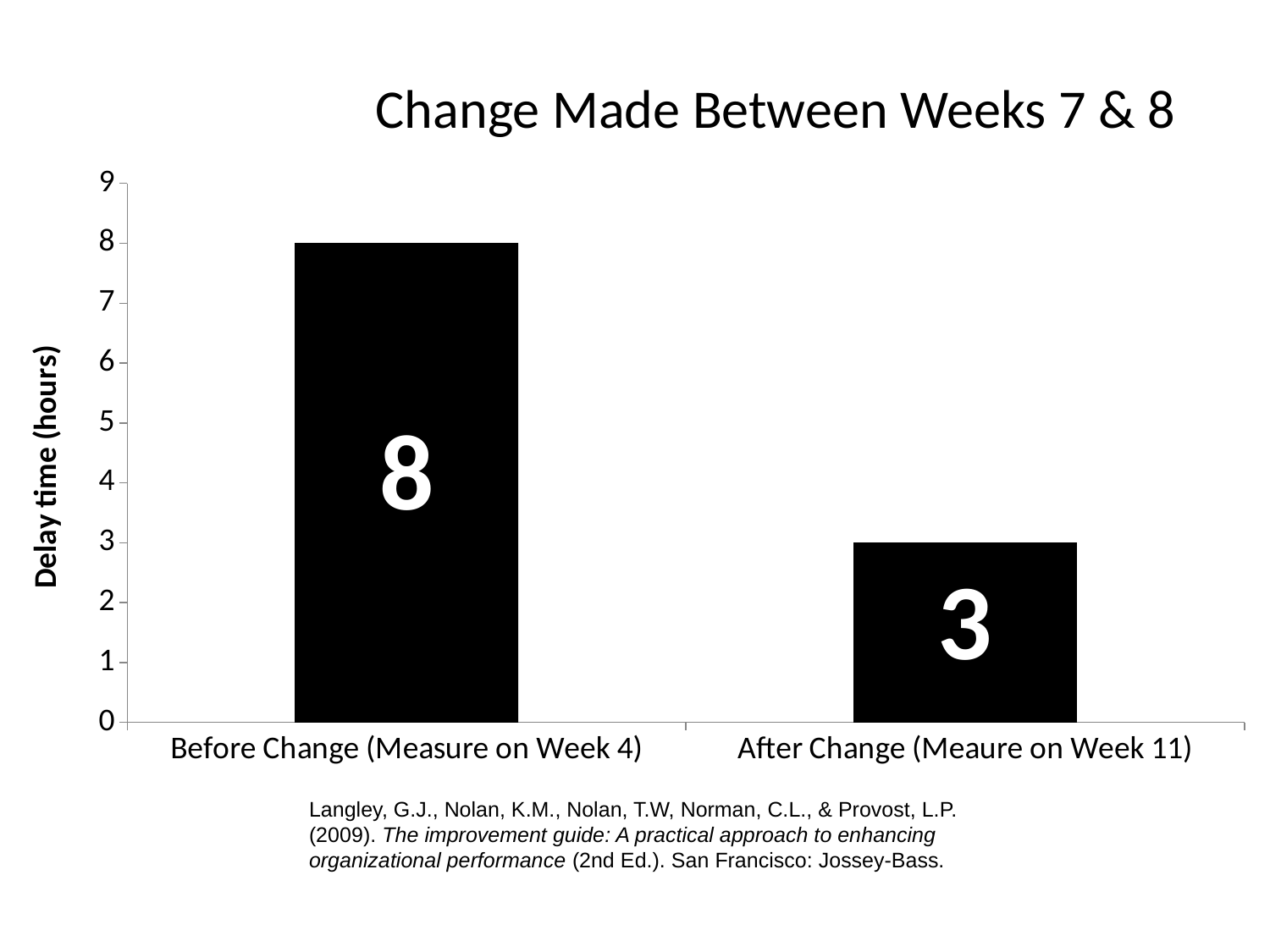
Do the values rise or fall from Before Change to After Change? fall What is the difference in delay time between Before Change and After Change? 5 What is the delay time for After Change (Meaure on Week 11)? 3 What is the delay time for Before Change (Measure on Week 4)? 8 What kind of chart is shown on the slide? bar chart Which category has the highest delay time? Before Change (Measure on Week 4) Which is larger, the delay time Before Change or After Change? Before Change (Measure on Week 4) Is the delay time for Before Change greater or less than 5? greater What is the title of the chart? Change Made Between Weeks 7 & 8 Which category has the lowest delay time? After Change (Meaure on Week 11) How many categories are shown on the chart? 2 Is the delay time for After Change greater or less than 4? less